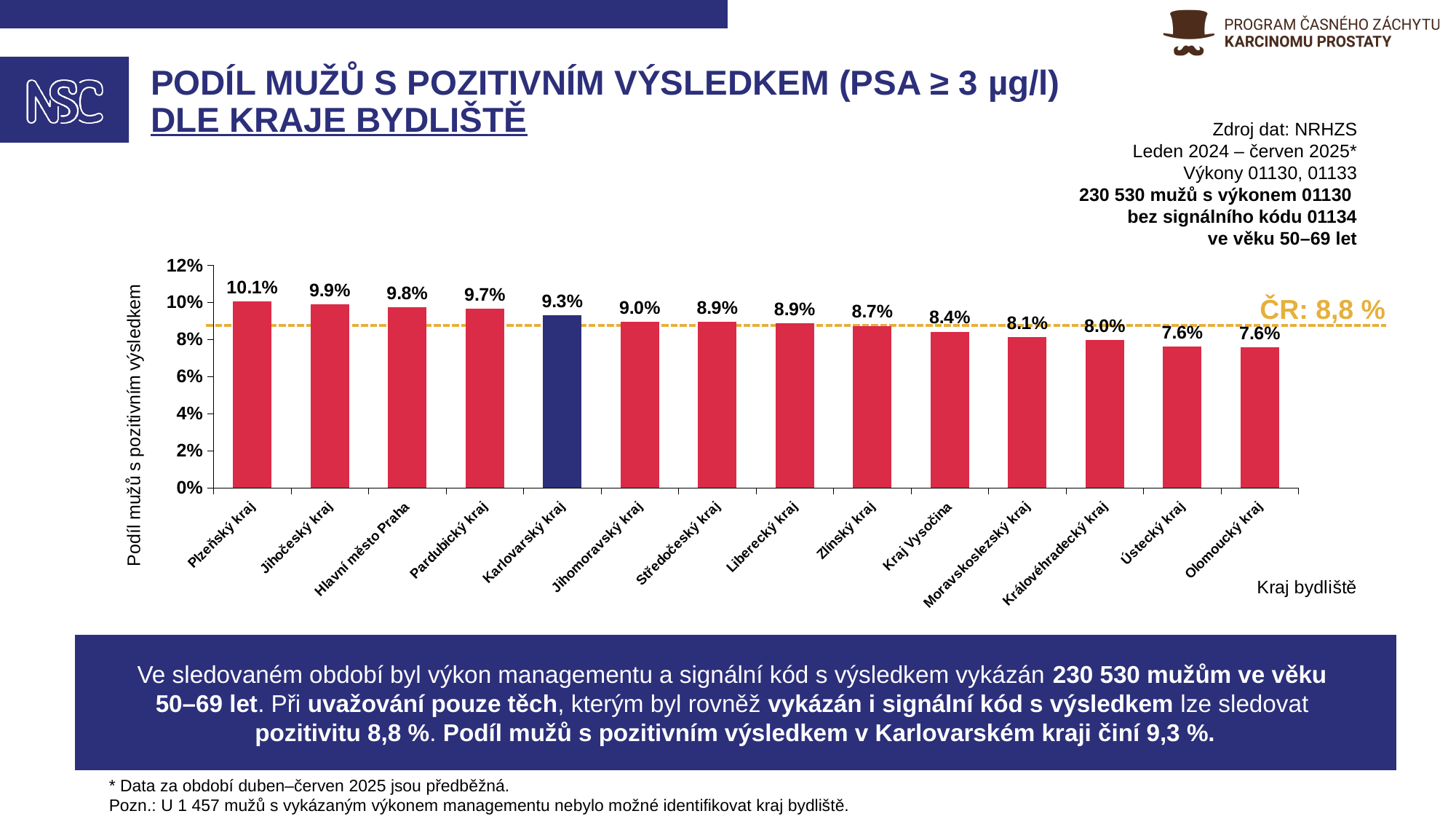
What value does the dashed horizontal line labelled ČR represent? 8,8 % What is the value for Karlovarský kraj? 9.3% Which is larger, the value for Jihomoravský kraj or the value for Moravskoslezský kraj? Jihomoravský kraj What is the difference between the values for Plzeňský kraj and Olomoucký kraj? 2.5% How many regions (bars) are shown in the chart? 14 Do the values rise or fall from left to right along the x axis? fall What is the value for Kraj Vysočina? 8.4% What is the value for Plzeňský kraj? 10.1% What is the value for Hlavní město Praha? 9.8% Which region has the highest share of men with a positive result? Plzeňský kraj Is the value for Královéhradecký kraj greater or less than 10%? less What kind of chart is shown on the slide? bar chart